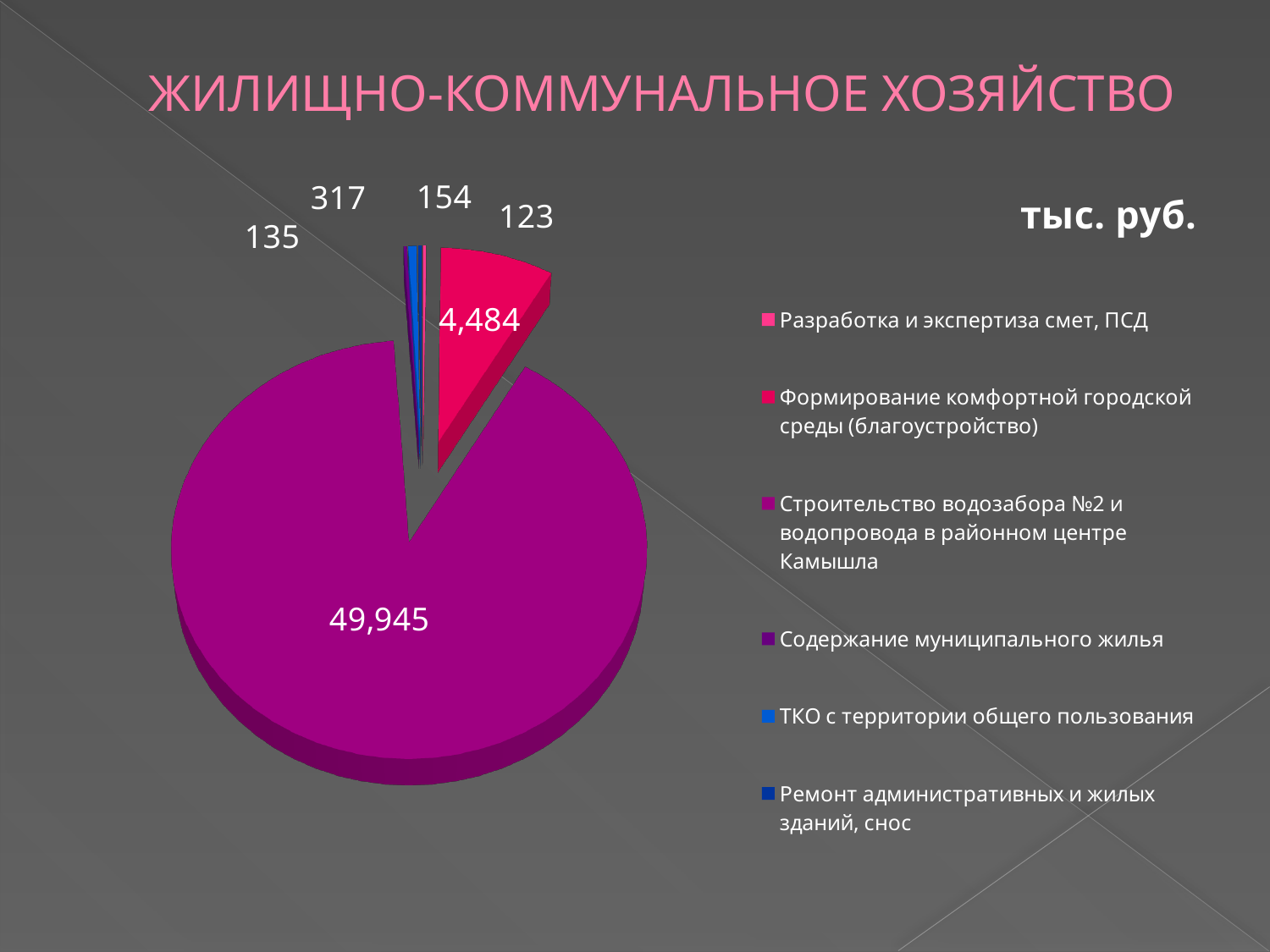
In what units are the values on the chart given, according to the label on the slide? тыс. руб. How many entries does the legend of the pie chart list? 6 What is the value of the second-largest slice in the pie chart? 4,484 What is the total of all the values shown on the pie chart? 55,158 How many slices does the pie chart have? 6 Which legend category does the largest slice (49,945) of the pie chart correspond to? Строительство водозабора №2 и водопровода в районном центре Камышла What is the value of the smallest slice in the pie chart? 123 What is the value of the largest slice in the pie chart? 49,945 What is the difference between the slices labelled 317 and 135? 182 What kind of chart is shown on the slide? pie chart What is the difference between the largest slice (49,945) and the second-largest slice (4,484)? 45,461 Which is larger among the small slices: the one labelled 317 or the one labelled 154? 317